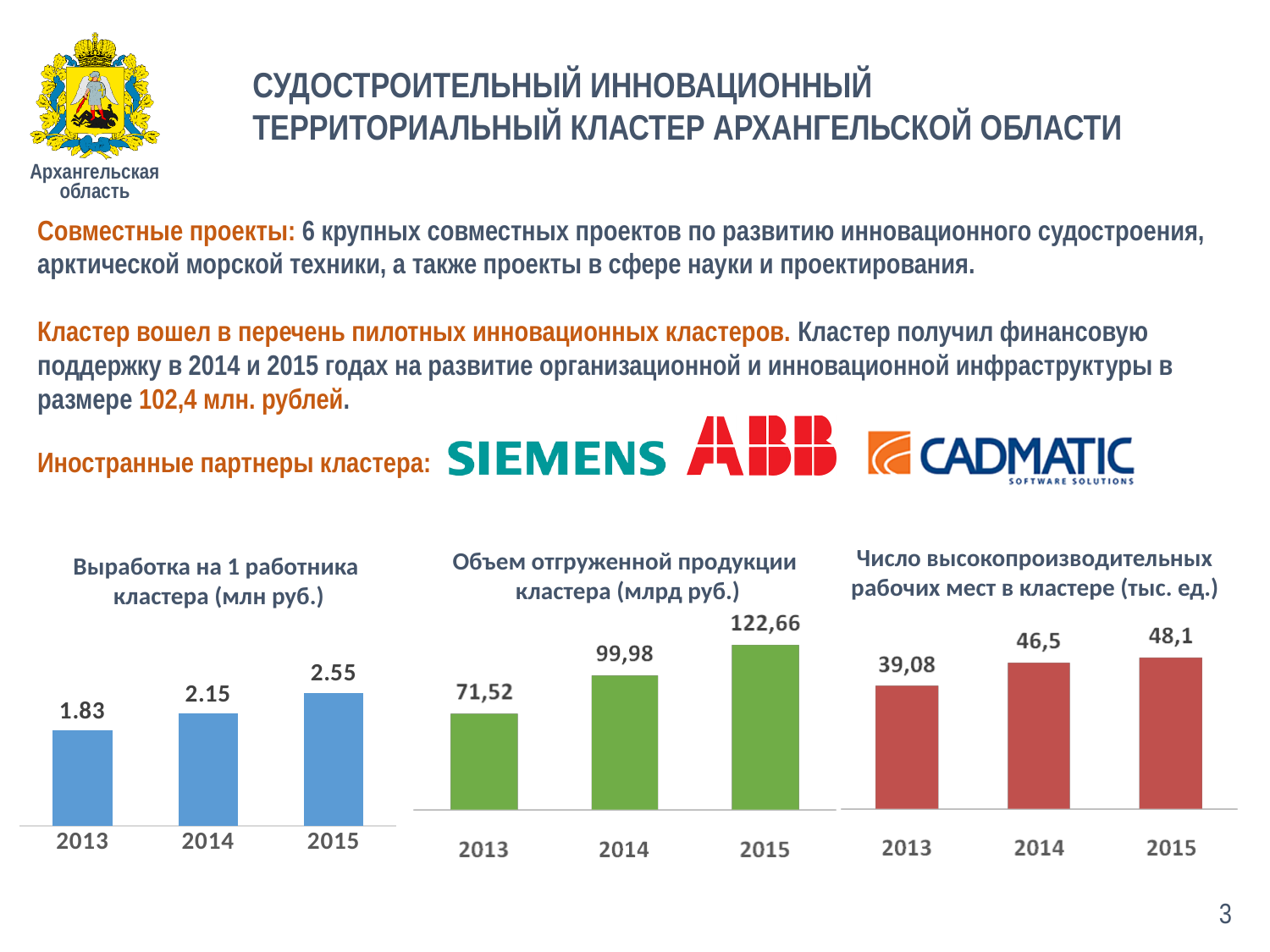
In the chart 'Число высокопроизводительных рабочих мест в кластере (тыс. ед.)', what is the value for 2014? 46,5 In the chart 'Объем отгруженной продукции кластера (млрд руб.)', what is the difference between the 2015 and 2013 values? 51,14 In the chart 'Выработка на 1 работника кластера (млн руб.)', what is the value for 2015? 2.55 In the chart 'Число высокопроизводительных рабочих мест в кластере (тыс. ед.)', which is larger, the value for 2013 or the value for 2015? 2015 What type of chart is 'Объем отгруженной продукции кластера (млрд руб.)'? Bar chart In the chart 'Объем отгруженной продукции кластера (млрд руб.)', which year has the highest value? 2015 In the chart 'Выработка на 1 работника кластера (млн руб.)', what is the difference between the 2015 and 2013 values? 0.72 How many years are shown in the chart 'Выработка на 1 работника кластера (млн руб.)'? 3 In the chart 'Число высокопроизводительных рабочих мест в кластере (тыс. ед.)', which year has the lowest value? 2013 What colour are the bars in the rightmost chart, 'Число высокопроизводительных рабочих мест в кластере (тыс. ед.)'? Red In the chart 'Объем отгруженной продукции кластера (млрд руб.)', what is the value for 2013? 71,52 In the chart 'Выработка на 1 работника кластера (млн руб.)', do the values rise or fall from 2013 to 2015? Rise